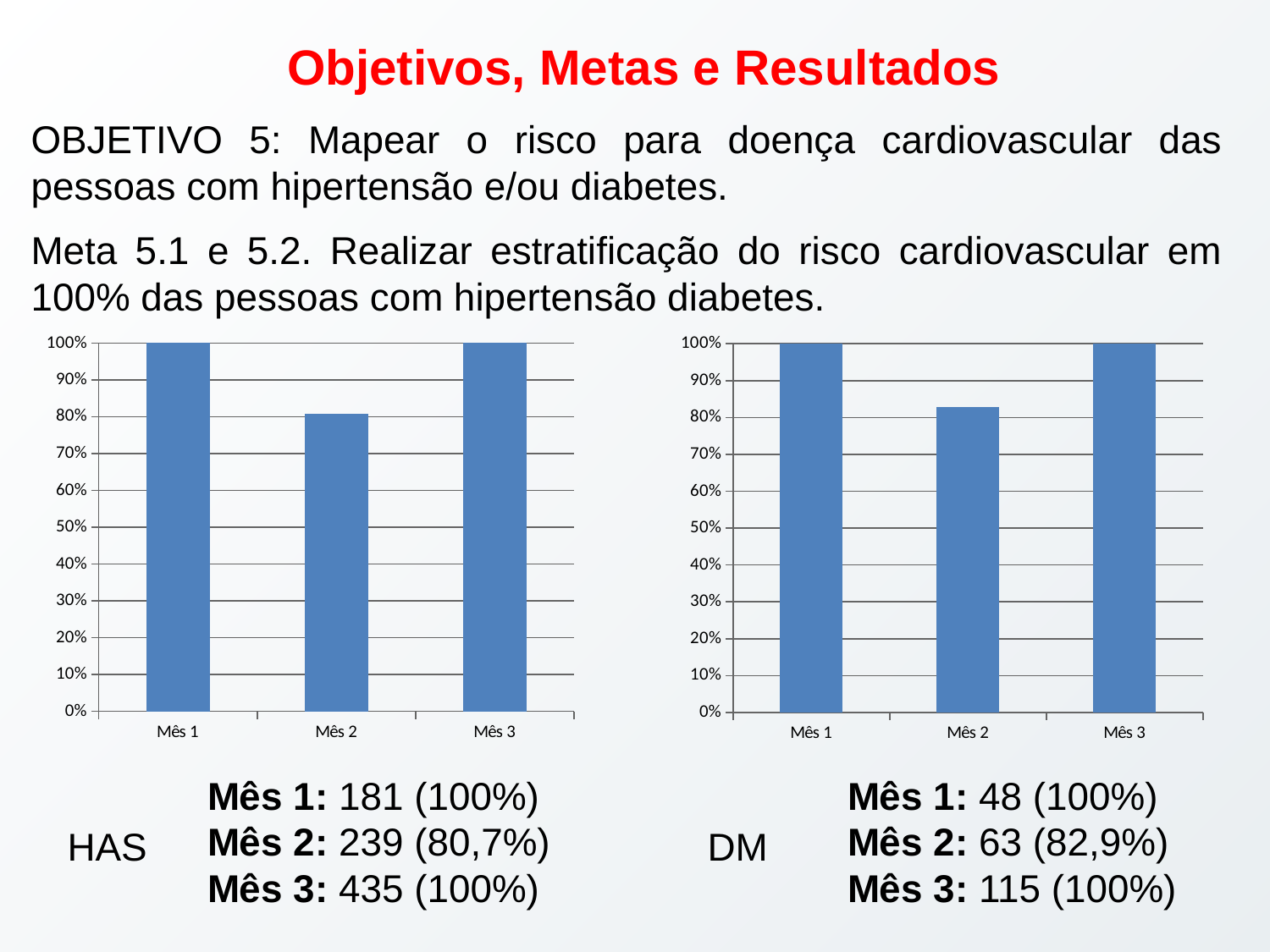
In the right chart (DM), what is the value for Mês 2? 82,9% In the left chart (HAS), which is larger, the value for Mês 1 or the value for Mês 2? Mês 1 In the right chart (DM), is the value for Mês 2 greater or less than 80%? greater In the right chart (DM), what is the value for Mês 3? 100% In the left chart (HAS), what is the value for Mês 2? 80,7% In the left chart (HAS), what is the difference between the value for Mês 3 and the value for Mês 2? 19,3% In the right chart (DM), which month has the lowest value? Mês 2 How many categories are shown on the x axis of the right chart (DM)? 3 What kind of chart is the left chart (HAS)? bar chart In the left chart (HAS), which month has the lowest value? Mês 2 In the left chart (HAS), is the value for Mês 2 greater or less than 90%? less In the left chart (HAS), what is the value for Mês 1? 100%